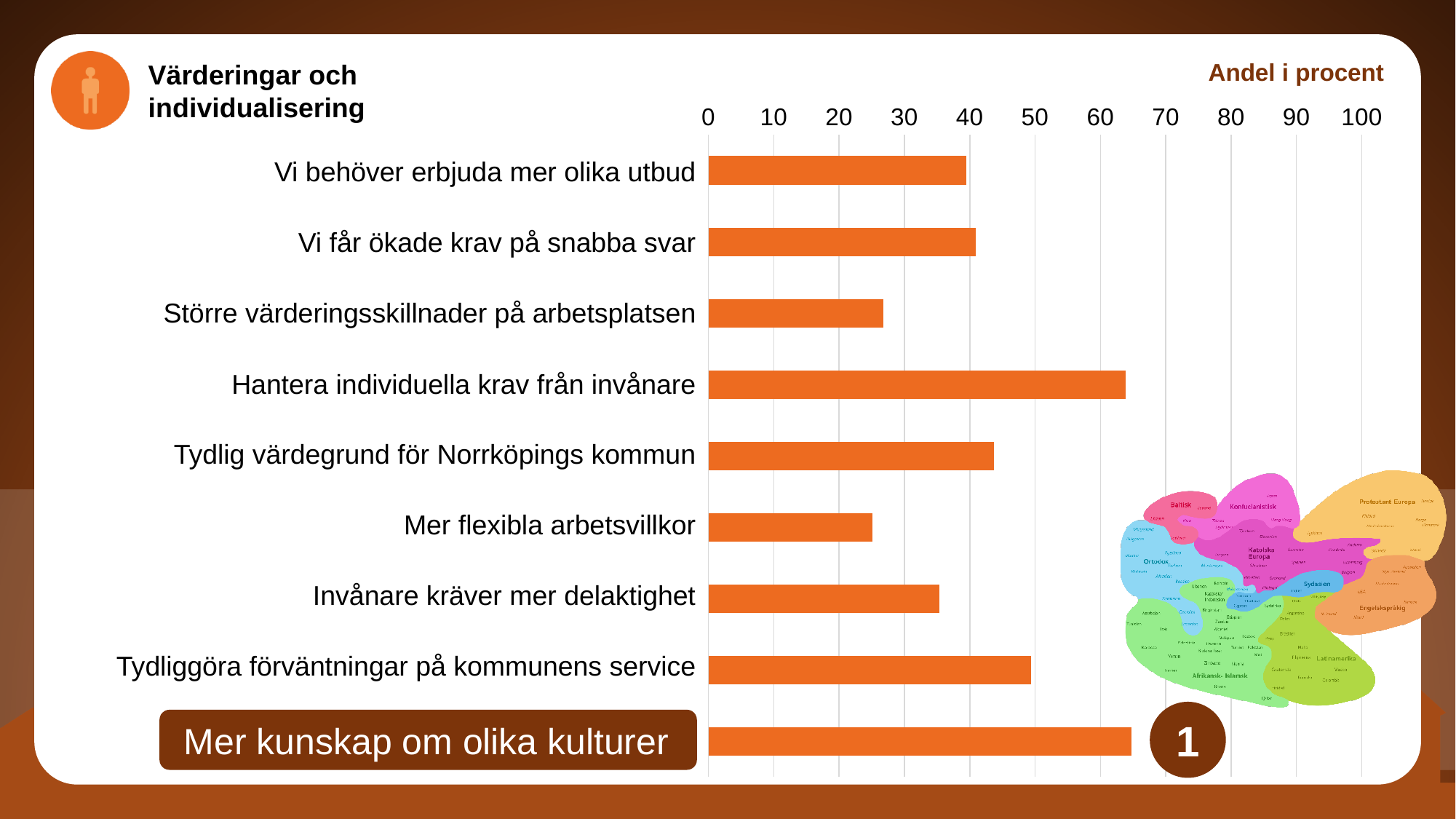
Is the value for "Tydliggöra förväntningar på kommunens service" greater or less than 40? greater Is the value for "Hantera individuella krav från invånare" greater or less than 60? greater Which has a larger value: "Hantera individuella krav från invånare" or "Mer flexibla arbetsvillkor"? Hantera individuella krav från invånare What kind of chart is shown on the slide? Bar chart Is the value for "Invånare kräver mer delaktighet" greater or less than 40? less What is the maximum value shown on the chart's axis? 100 What unit label is shown above the chart's axis? Andel i procent How many categories are plotted in the chart? 9 Which has a larger value: "Tydliggöra förväntningar på kommunens service" or "Invånare kräver mer delaktighet"? Tydliggöra förväntningar på kommunens service